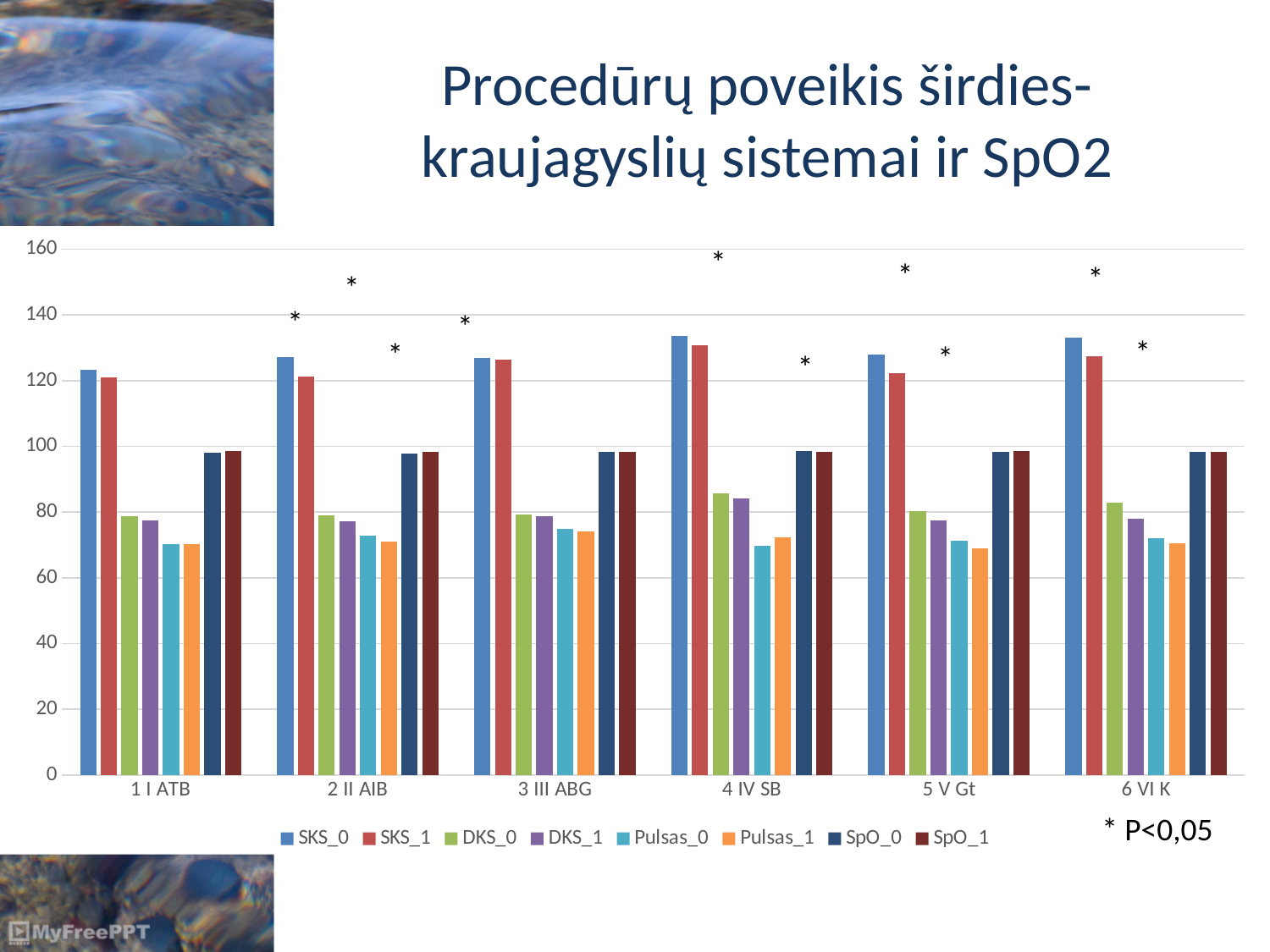
For 1 I ATB, which is larger: SKS_0 or Pulsas_0? SKS_0 Is the value of DKS_0 for 4 IV SB greater or less than 80? greater How many series does the chart's legend list? 8 What does the asterisk note below the chart say? * P<0,05 How many categories are shown on the x axis of the chart? 6 What kind of chart is shown on the slide? bar chart Is the value of SKS_0 for 4 IV SB greater or less than 120? greater Is the value of SpO_0 for 1 I ATB greater or less than 100? less What is the title of the slide containing the chart? Procedūrų poveikis širdies-kraujagyslių sistemai ir SpO2 For 4 IV SB, which is larger: DKS_0 or Pulsas_1? DKS_0